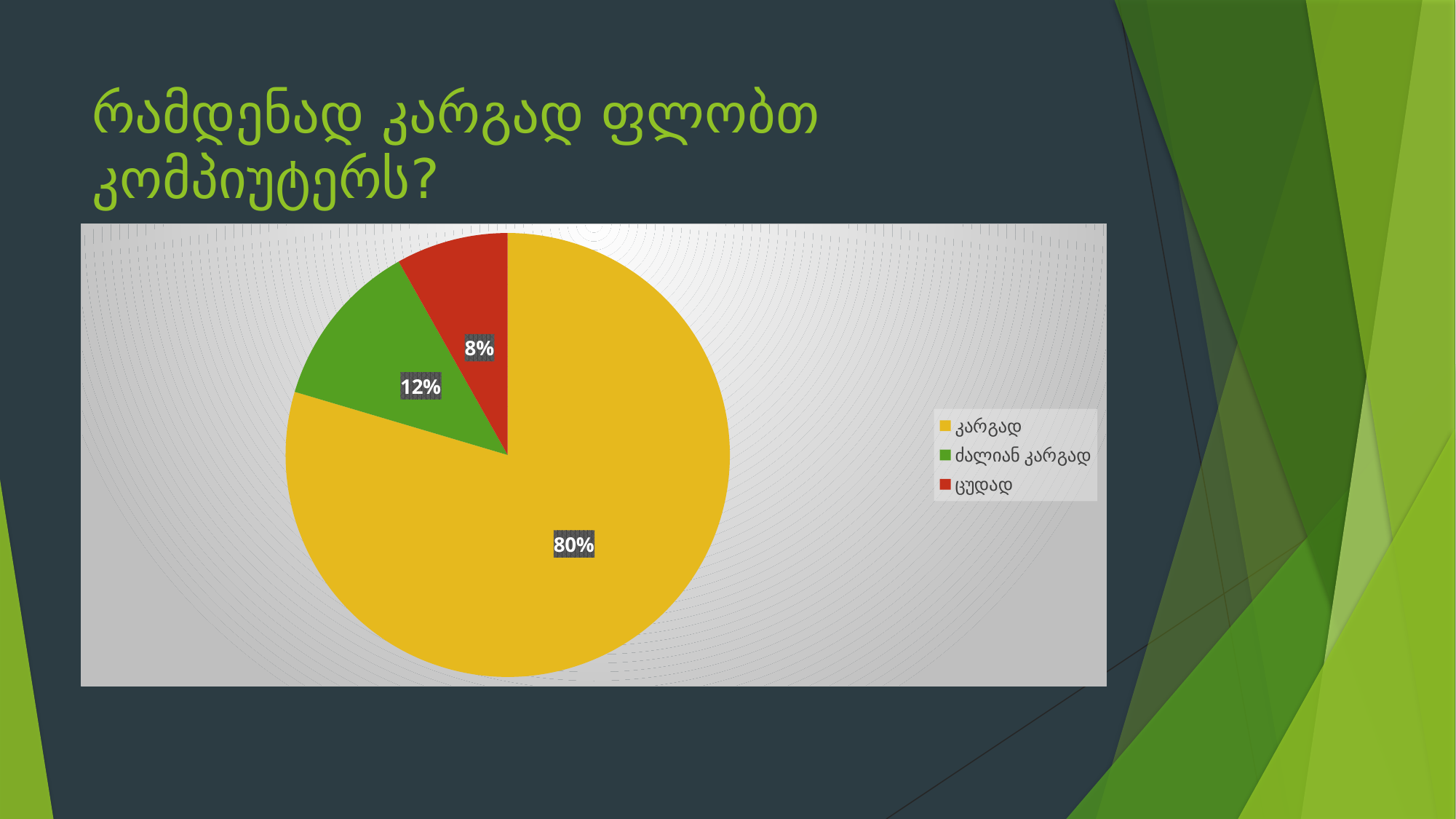
What percentage of the pie is the slice for კარგად? 80% What colour is the slice for ცუდად? red How many slices does the pie chart have? 3 What is the difference in percentage points between the ძალიან კარგად slice and the ცუდად slice? 4 What is the difference in percentage points between the კარგად slice and the ძალიან კარგად slice? 68 What percentage of the pie is the slice for ცუდად? 8% Which category has the largest slice of the pie? კარგად What percentage of the pie is the slice for ძალიან კარგად? 12% What kind of chart is shown on the slide? pie chart Which category has the smallest slice of the pie? ცუდად What is the title of the slide containing the pie chart? რამდენად კარგად ფლობთ კომპიუტერს? Which slice is larger, ძალიან კარგად or ცუდად? ძალიან კარგად